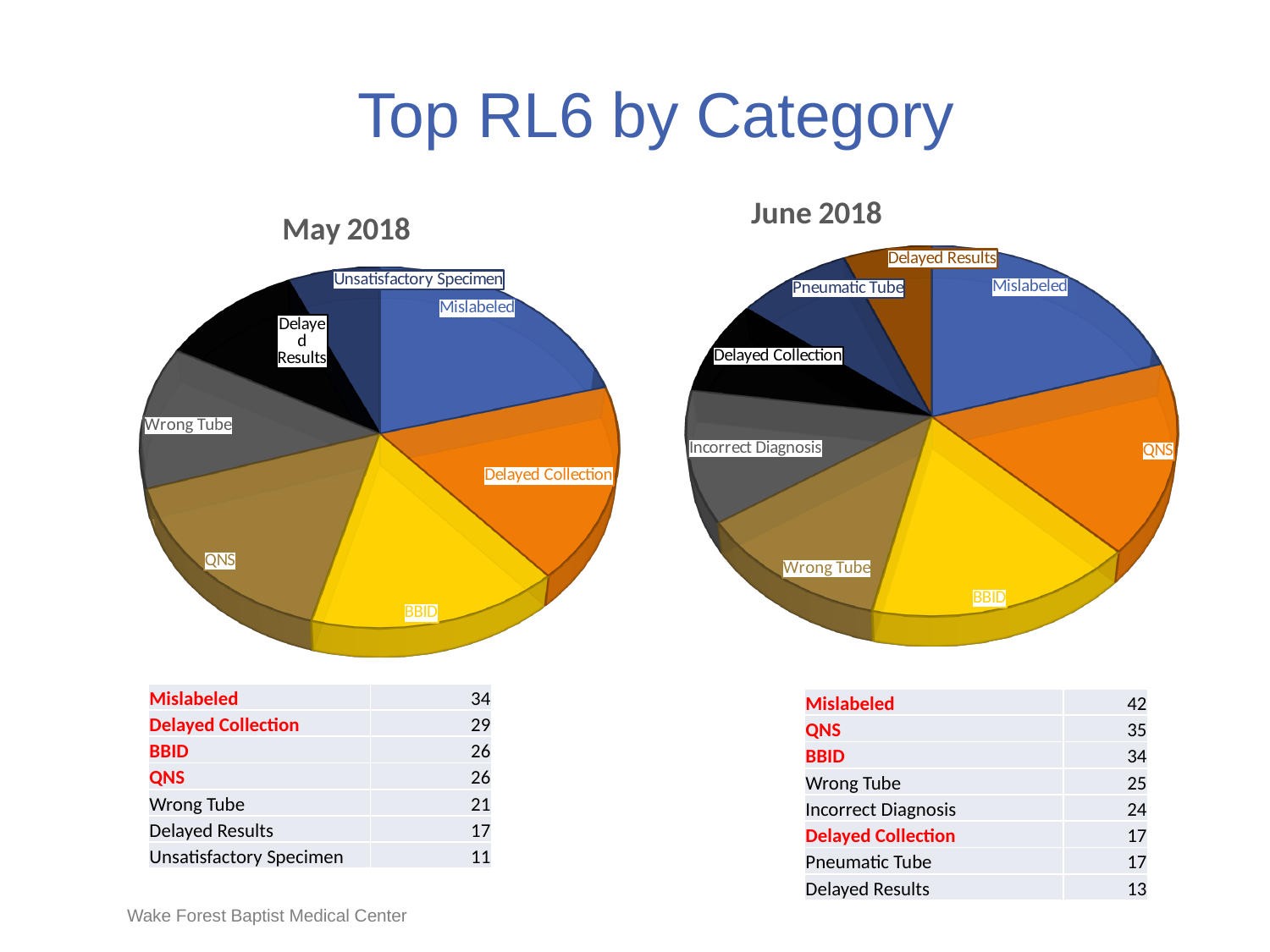
In the June 2018 chart, what is the difference between QNS and Delayed Collection? 18 In the May 2018 chart, which category has the smallest value? Unsatisfactory Specimen In the June 2018 chart, which is larger, Wrong Tube or Delayed Collection? Wrong Tube In the June 2018 chart, which category has the smallest value? Delayed Results How many categories does the May 2018 pie chart have? 7 Which category appears in the June 2018 chart but not in the May 2018 chart, besides Pneumatic Tube? Incorrect Diagnosis In the June 2018 chart, what is the value for Incorrect Diagnosis? 24 What kind of chart is the May 2018 chart? Pie chart How many categories does the June 2018 pie chart have? 8 In the May 2018 chart, what is the difference between Mislabeled and Wrong Tube? 13 In the June 2018 chart, which category has the largest value? Mislabeled In the May 2018 chart, what is the value for Delayed Collection? 29